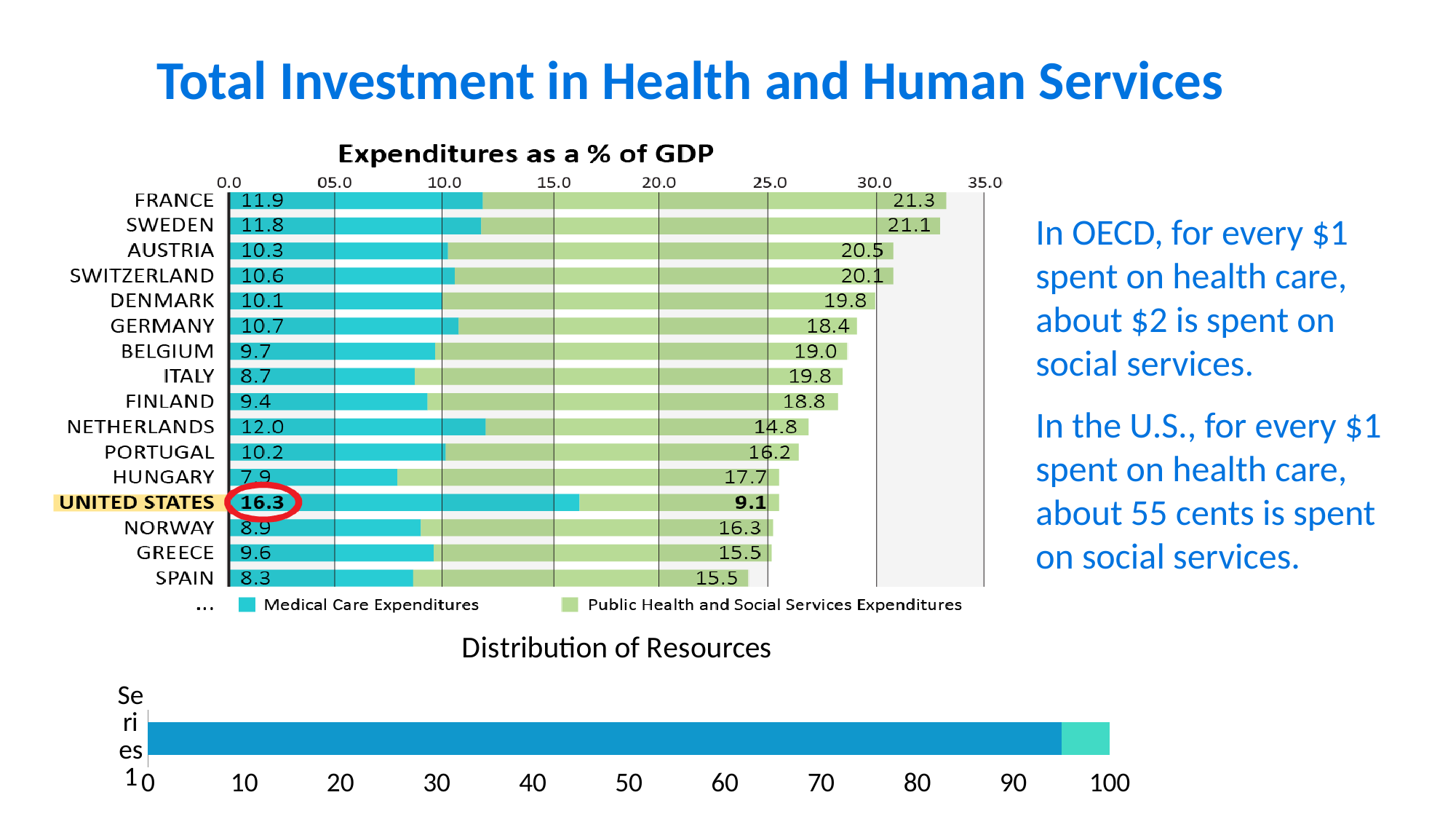
In the 'Expenditures as a % of GDP' chart, what is the Medical Care Expenditures value for the United States? 16.3 In the 'Expenditures as a % of GDP' chart, which country has the lowest Medical Care Expenditures value? Hungary In the 'Expenditures as a % of GDP' chart, which country has the highest Medical Care Expenditures value? United States In the 'Expenditures as a % of GDP' chart, what is the difference between France's and the United States' Public Health and Social Services Expenditures values? 12.2 In the 'Expenditures as a % of GDP' chart, what is the total of the two segments for the United States bar? 25.4 In the 'Expenditures as a % of GDP' chart, which is larger: Germany's Medical Care Expenditures or Belgium's Medical Care Expenditures? Germany How many series does the legend of the 'Expenditures as a % of GDP' chart list? 2 How many countries are shown in the 'Expenditures as a % of GDP' chart? 16 In the 'Expenditures as a % of GDP' chart, what is the Public Health and Social Services Expenditures value for France? 21.3 What kind of chart is the 'Expenditures as a % of GDP' chart? Stacked bar chart In the 'Expenditures as a % of GDP' chart, which country has the lowest Public Health and Social Services Expenditures value? United States In the 'Distribution of Resources' chart at the bottom, is the dark blue segment greater or less than 90? greater